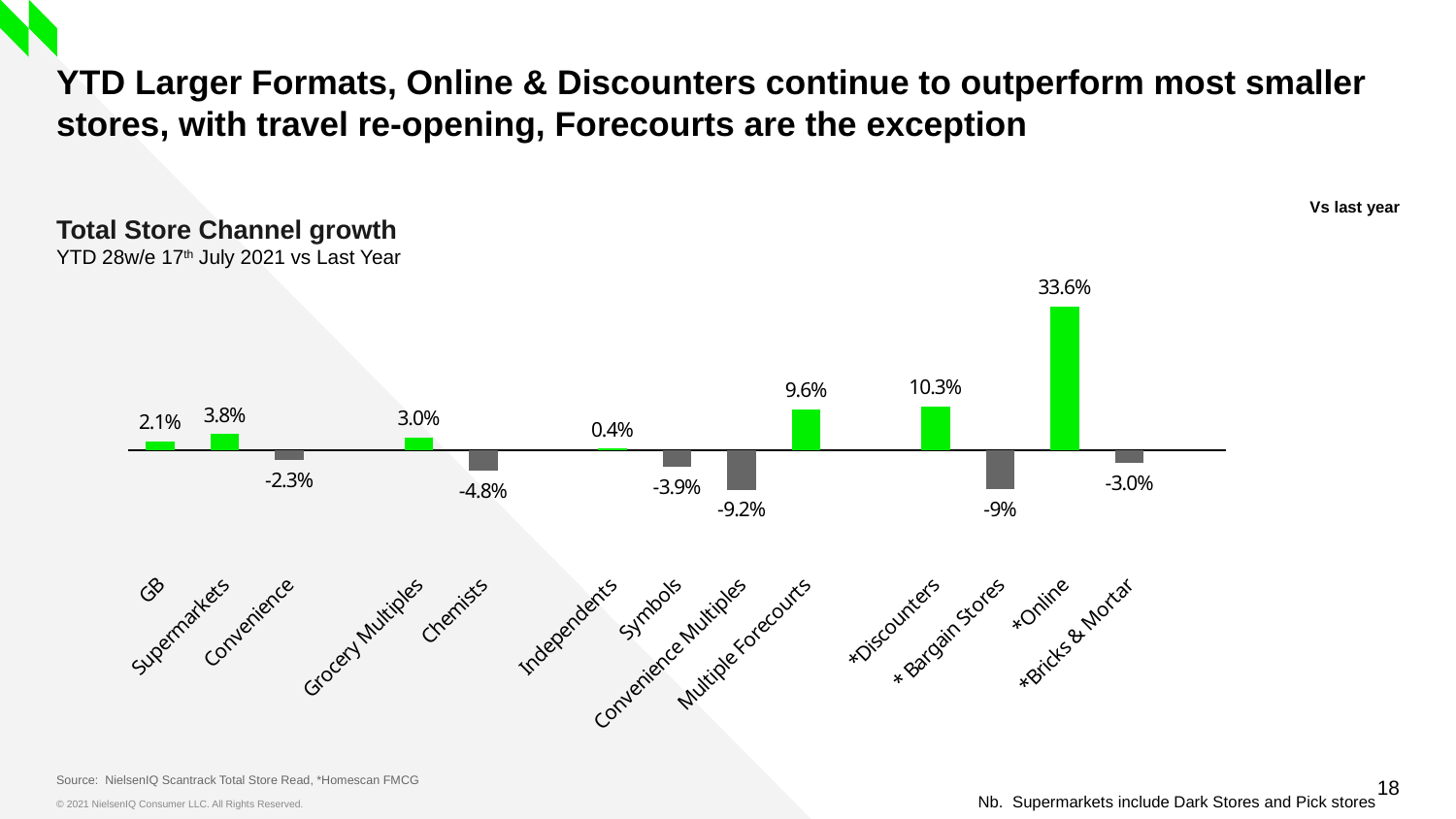
Which category has the lowest value? Convenience Multiples Which category has the highest value? *Online What is the value for *Online in the Total Store Channel growth chart? 33.6% What is the value for Supermarkets? 3.8% Which is larger, the value for Supermarkets or the value for Grocery Multiples? Supermarkets What is the title of the chart? Total Store Channel growth What is the value for Convenience Multiples? -9.2% What is the difference between the values for *Discounters and Multiple Forecourts? 0.7% What kind of chart is shown on the slide? Bar chart How many categories are shown in the chart? 13 What is the value for Multiple Forecourts? 9.6% What is the value for Chemists? -4.8%